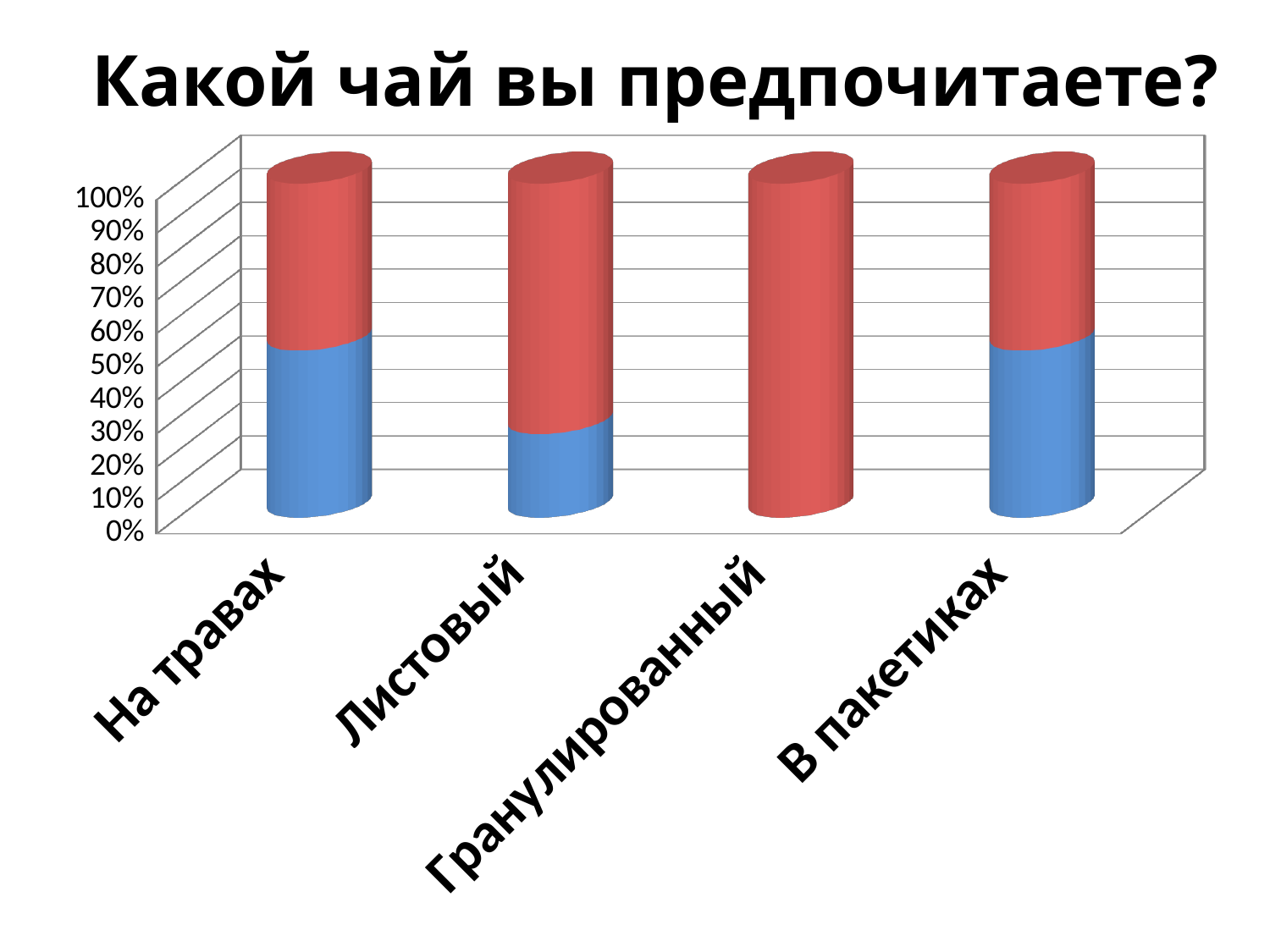
Which category's bar consists entirely of the red segment? Гранулированный Is the blue segment for Листовый greater or less than 40%? less Is the blue segment for На травах greater or less than 40%? greater Is the blue segment for В пакетиках greater or less than 30%? greater Which category has the smallest blue segment in the chart? Гранулированный What kind of chart is shown on the slide? stacked bar chart Which has the larger blue segment, На травах or Листовый? На травах What is the title of the chart? Какой чай вы предпочитаете? How many categories are shown on the x axis of the chart? 4 What is the highest value shown on the vertical axis of the chart? 100% Which has the larger red segment, Листовый or В пакетиках? Листовый Which category has the largest red segment in the chart? Гранулированный